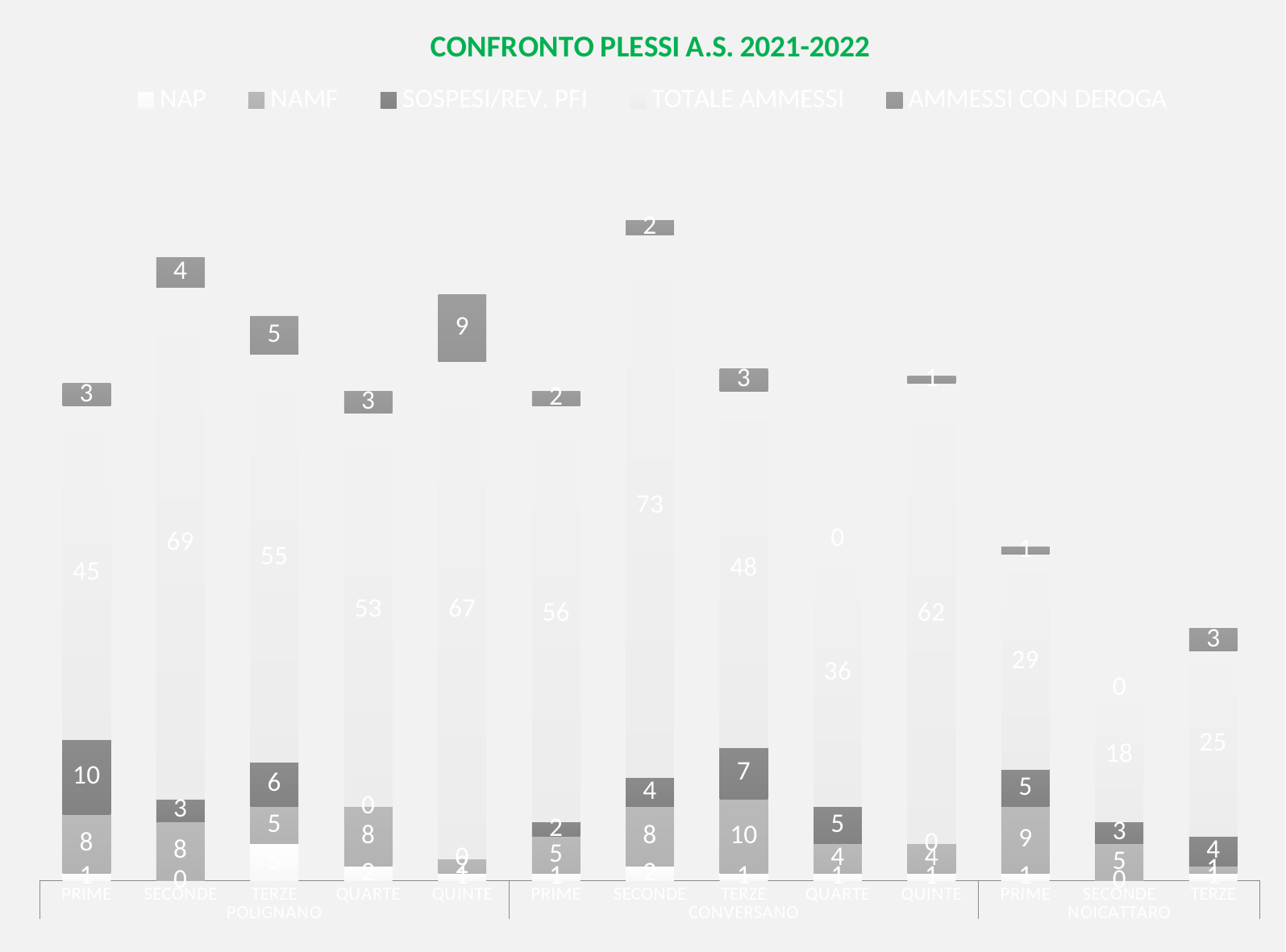
Which category has the lowest TOTALE AMMESSI value? SECONDE (NOICATTARO) Which category has the highest AMMESSI CON DEROGA value? QUINTE (POLIGNANO) How many class categories are plotted along the x axis? 13 What is the difference between the TOTALE AMMESSI values for SECONDE and PRIME in POLIGNANO? 24 Which category has the highest TOTALE AMMESSI value? SECONDE (CONVERSANO) What is the TOTALE AMMESSI value for SECONDE in CONVERSANO? 73 How many series does the legend list? 5 Which is larger: the NAMF value for TERZE in CONVERSANO or the NAMF value for PRIME in POLIGNANO? TERZE in CONVERSANO What is the title of the chart? CONFRONTO PLESSI A.S. 2021-2022 What is the SOSPESI/REV. PFI value for PRIME in POLIGNANO? 10 What kind of chart is shown on the slide? stacked bar chart What is the AMMESSI CON DEROGA value for QUINTE in POLIGNANO? 9